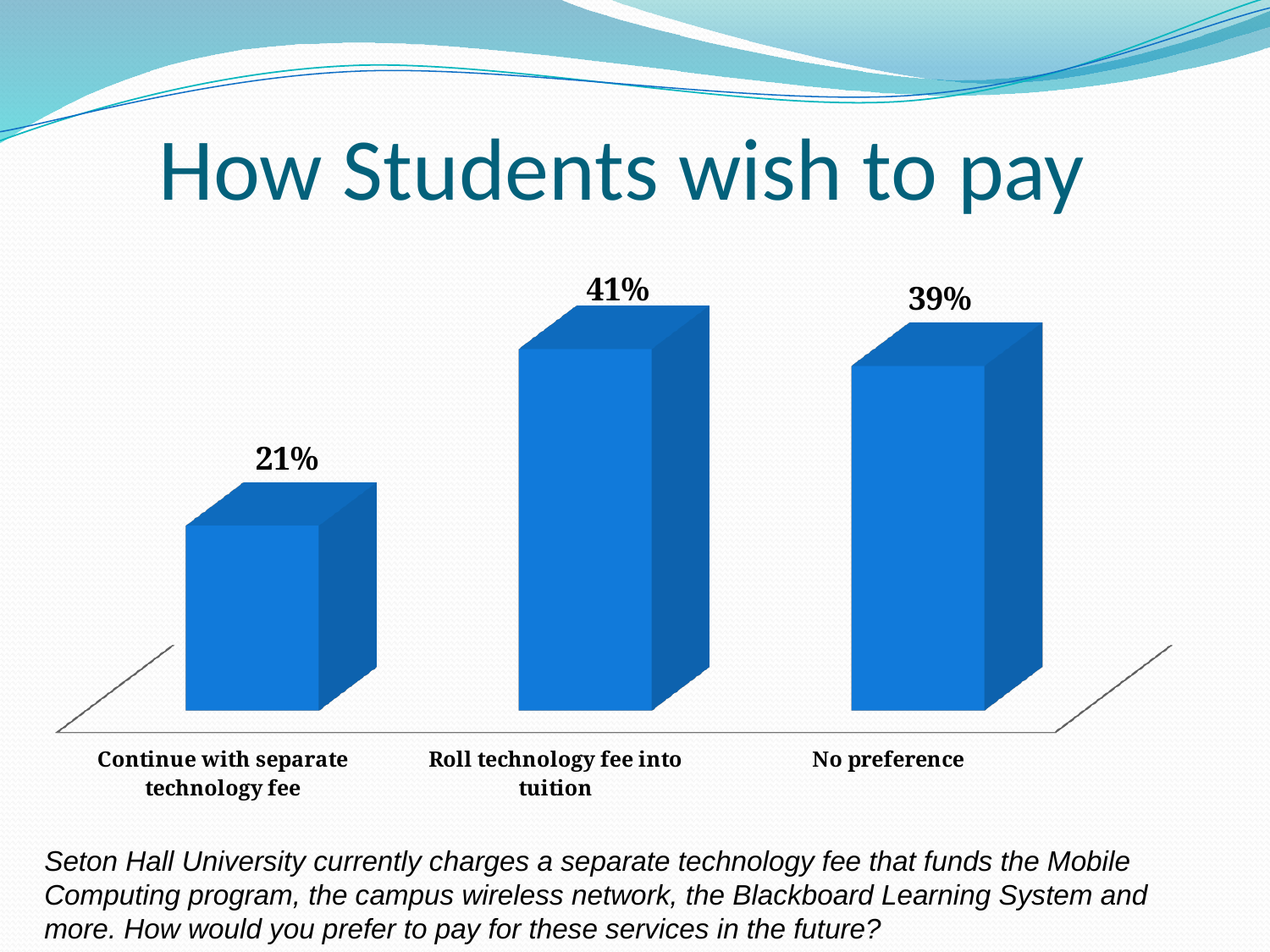
What is the title of the slide? How Students wish to pay What percentage of students chose 'Roll technology fee into tuition'? 41% What percentage of students chose 'No preference'? 39% Which option has the lowest percentage? Continue with separate technology fee What colour are the bars in the chart? Blue What is the difference in percentage points between 'No preference' and 'Continue with separate technology fee'? 18 What percentage of students chose 'Continue with separate technology fee'? 21% Which option has the highest percentage? Roll technology fee into tuition What is the difference in percentage points between 'Roll technology fee into tuition' and 'Continue with separate technology fee'? 20 Which is larger: the percentage for 'No preference' or for 'Continue with separate technology fee'? No preference What kind of chart is shown on the slide? Bar chart How many categories are shown in the chart? 3